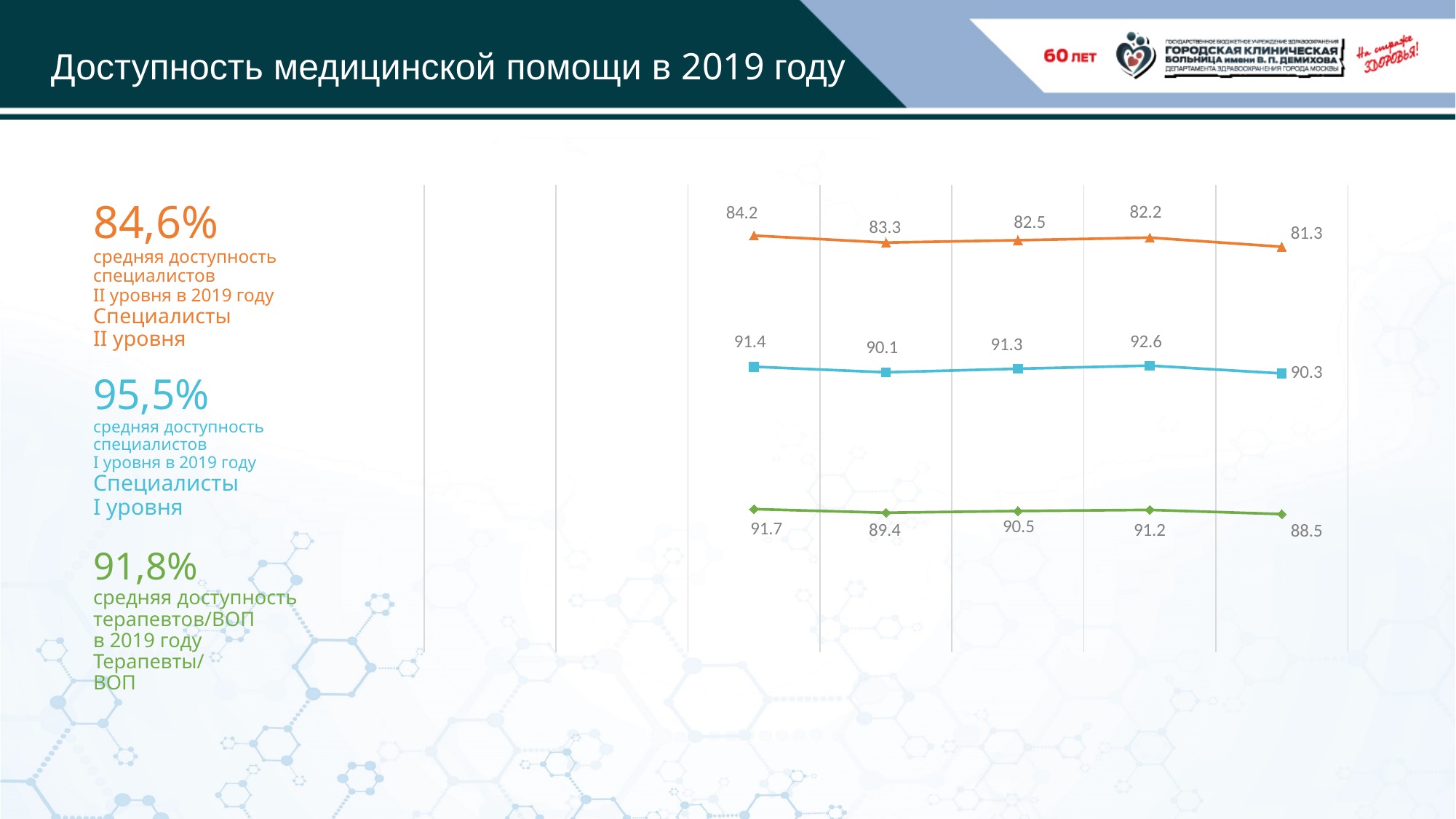
What is the difference between the first and last values on the green line (91.7 and 88.5)? 3.2 What is the lowest value on the orange line (Специалисты II уровня)? 81.3 What is the first (leftmost) value on the orange line (Специалисты II уровня)? 84.2 What is the highest value on the blue line (Специалисты I уровня)? 92.6 What is the last (rightmost) value on the blue line (Специалисты I уровня)? 90.3 At the fourth point, which line has the larger value: the blue line (Специалисты I уровня) or the green line (Терапевты/ВОП)? blue line (Специалисты I уровня) How many data points does each line in the chart have? 5 What is the difference between the first and last values on the orange line (84.2 and 81.3)? 2.9 What kind of chart is shown on the slide? line chart What is the highest value on the green line (Терапевты/ВОП)? 91.7 Do the values on the orange line (Специалисты II уровня) rise or fall from left to right? fall How many lines (series) are plotted in the chart? 3